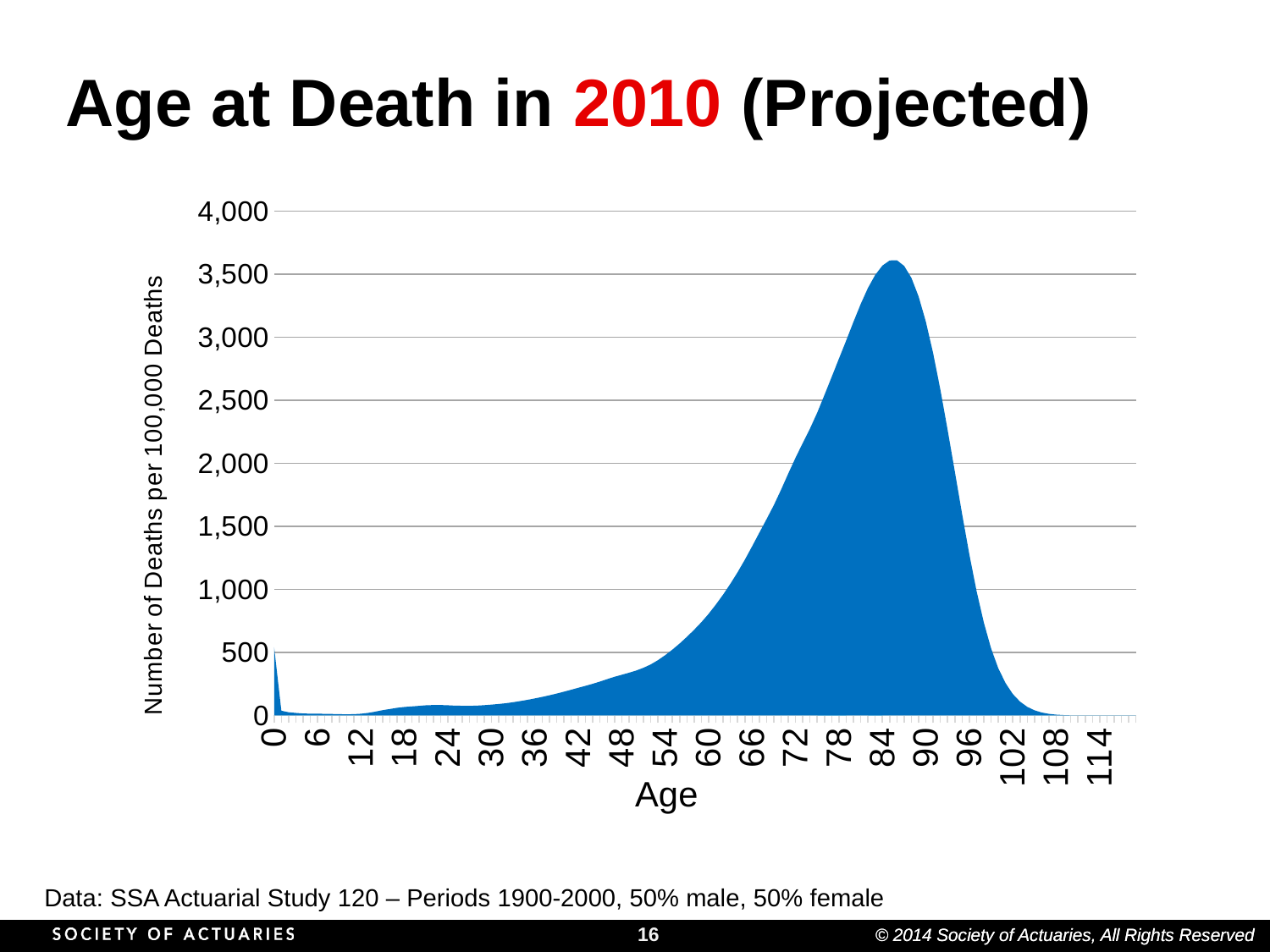
What is the title of the chart on the slide? Age at Death in 2010 (Projected) Is the value at age 60 greater or less than 1,000? less What kind of chart is shown on the slide? area chart Is the value at age 84 greater or less than 3,000? greater Is the value at age 78 greater or less than 2,000? greater Between which two labeled ages does the curve reach its peak? 84 and 90 What is the label of the vertical axis? Number of Deaths per 100,000 Deaths Do the values rise or fall as age increases from 90 to 108? fall Which is larger, the value at age 78 or the value at age 48? age 78 Do the values rise or fall as age increases from 60 to 84? rise